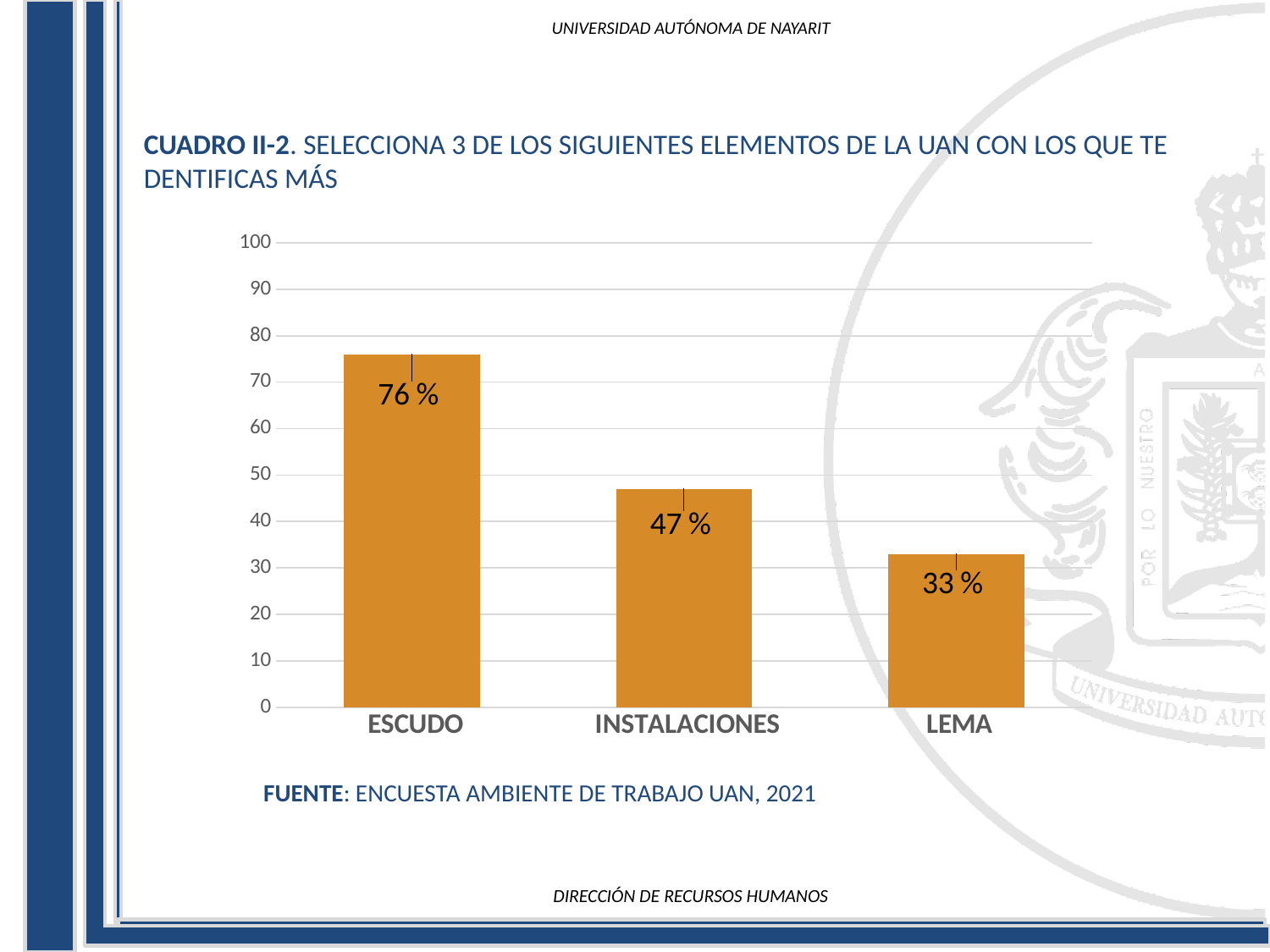
What is the value for LEMA? 33 % Do the values rise or fall from left to right across the categories? Fall Which category has the highest value? ESCUDO Is the value for ESCUDO greater or less than 70? greater What is the value for INSTALACIONES? 47 % What is the difference between the values for INSTALACIONES and LEMA? 14 % How many categories are shown in the chart? 3 What kind of chart is shown on the slide? Bar chart Which is larger, the value for INSTALACIONES or the value for LEMA? INSTALACIONES Which category has the lowest value? LEMA What is the difference between the values for ESCUDO and INSTALACIONES? 29 % What is the value for ESCUDO? 76 %